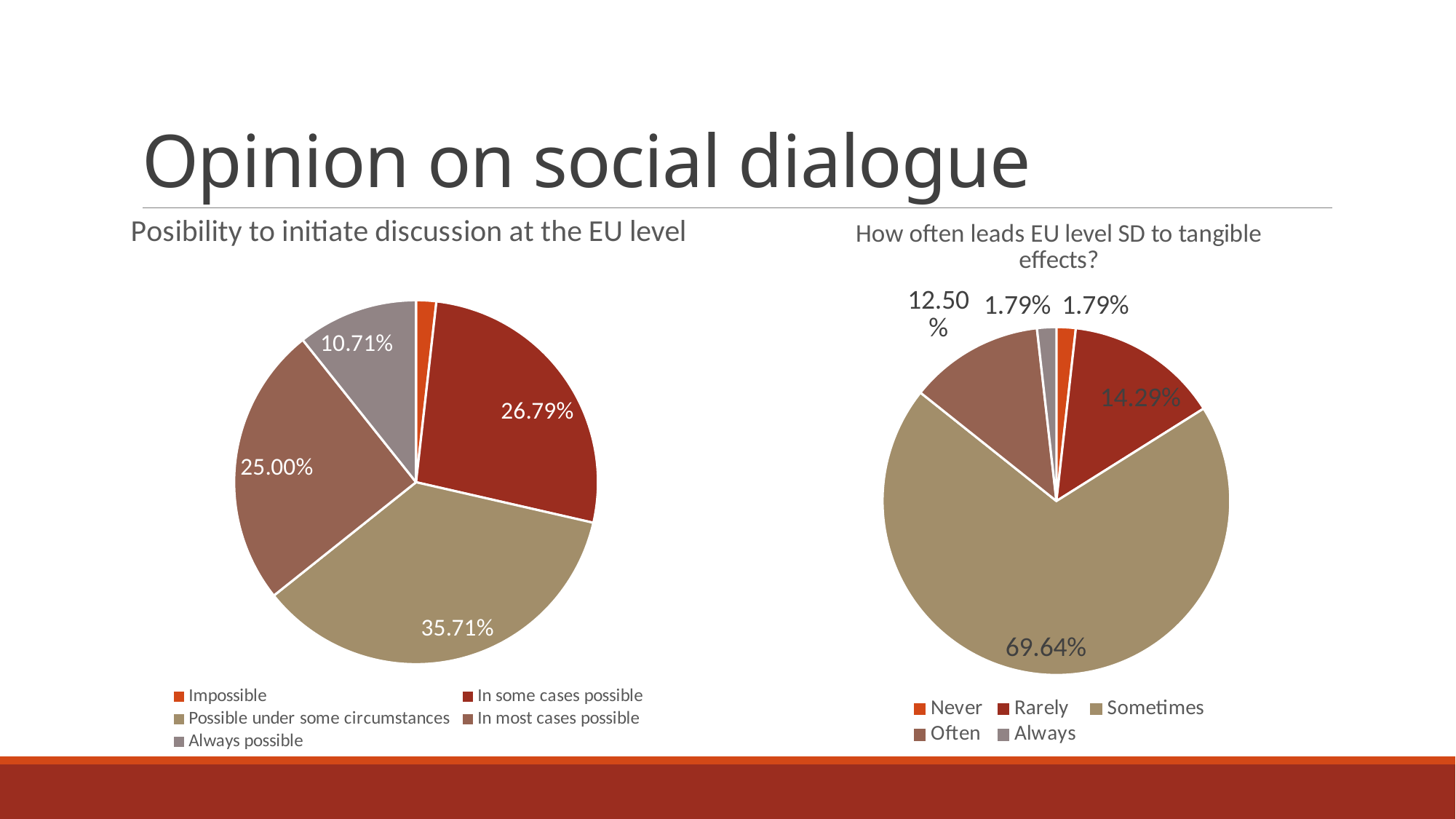
In the chart 'How often leads EU level SD to tangible effects?', what share is labelled for 'Rarely'? 14.29% In the chart 'Posibility to initiate discussion at the EU level', what is the difference between the shares for 'In some cases possible' and 'In most cases possible'? 1.79% In the chart 'Posibility to initiate discussion at the EU level', how many categories does the legend list? 5 In the chart 'Posibility to initiate discussion at the EU level', what share is labelled for 'Always possible'? 10.71% In the chart 'Posibility to initiate discussion at the EU level', what share is labelled for 'Possible under some circumstances'? 35.71% In the chart 'How often leads EU level SD to tangible effects?', what share is labelled for 'Sometimes'? 69.64% In the chart 'How often leads EU level SD to tangible effects?', what is the combined share of 'Rarely' and 'Sometimes'? 83.93% In the chart 'How often leads EU level SD to tangible effects?', which is larger, the share for 'Rarely' or the share for 'Often'? Rarely What type of chart is used on the right side of the slide, titled 'How often leads EU level SD to tangible effects?'? Pie chart In the chart 'How often leads EU level SD to tangible effects?', what share is labelled for 'Often'? 12.50% In the chart 'Posibility to initiate discussion at the EU level', which category has the largest slice? Possible under some circumstances In the chart 'Posibility to initiate discussion at the EU level', which category has the smallest slice? Impossible